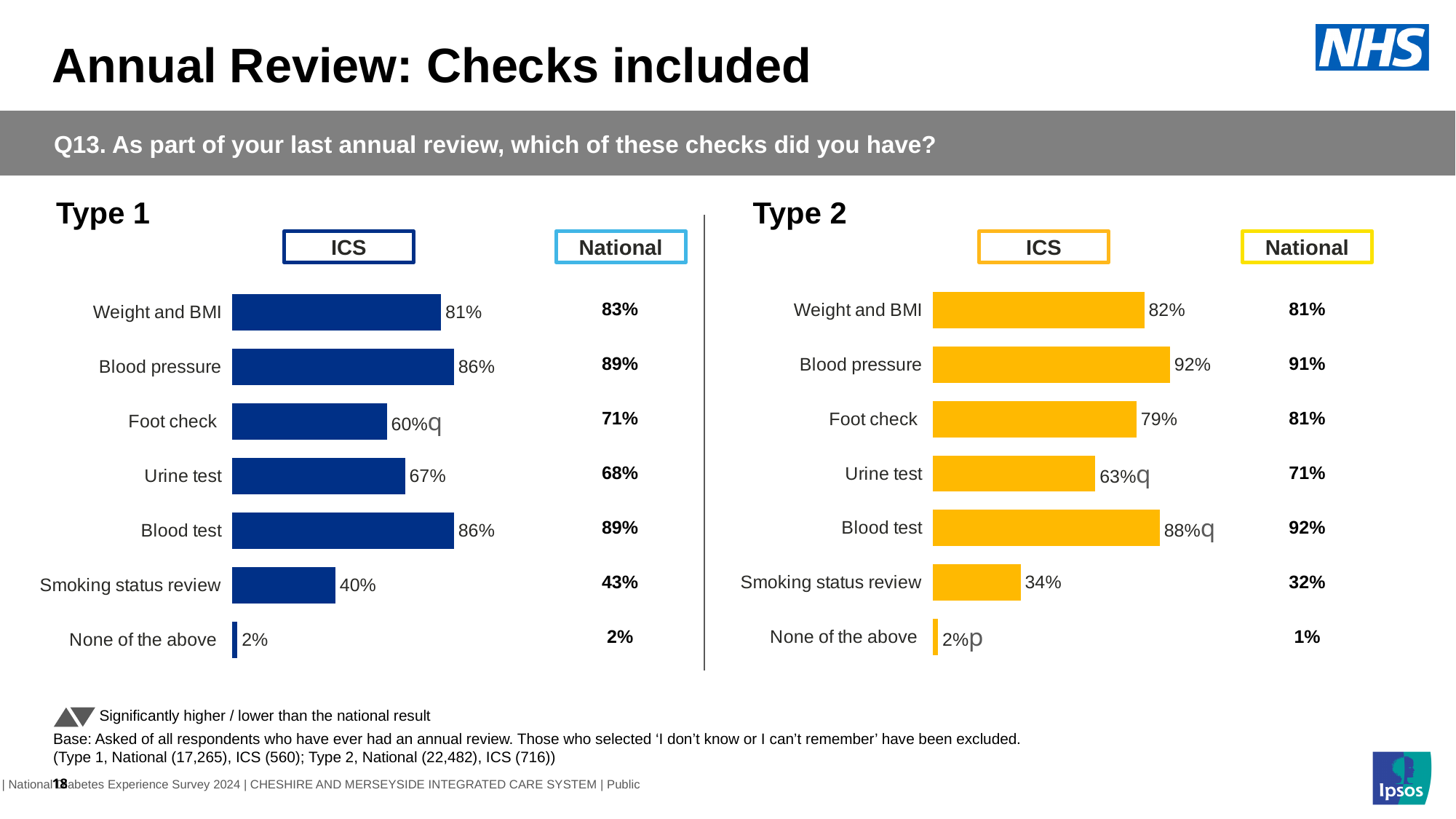
In the Type 1 chart, what is the ICS value for Foot check? 60% What colour are the ICS bars in the Type 2 chart? Yellow In the Type 1 chart, what is the difference between the National and ICS values for Foot check? 11% In the Type 2 chart, what is the National value for Blood test? 92% In the Type 2 chart, which is larger for Smoking status review: the ICS value or the National value? ICS How many checks (categories) are listed in the Type 1 chart? 7 In the Type 1 chart, which category has the lowest ICS value? None of the above In the Type 2 chart, what is the difference between the ICS and National values for Urine test? 8% What type of chart is used to show the ICS values in the Type 1 chart? Bar chart In the Type 2 chart, what is the ICS value for Blood pressure? 92% In the Type 2 chart, which check has the highest ICS value? Blood pressure In the Type 1 chart, what is the National value for Smoking status review? 43%